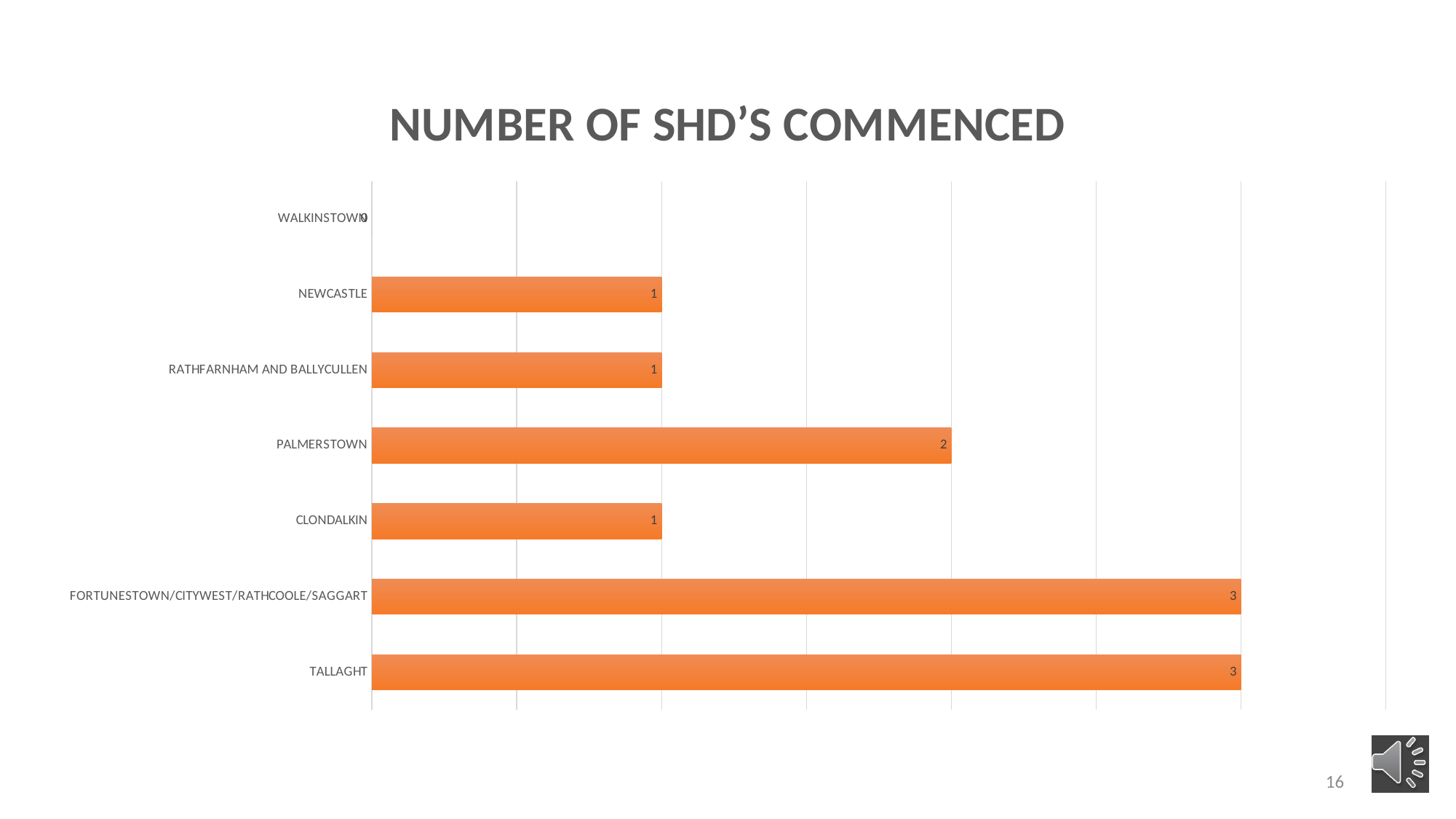
What is the number of SHD's commenced for Palmerstown? 2 What is the title of the chart? NUMBER OF SHD'S COMMENCED How many categories are shown in the chart? 7 What is the difference between the values for Fortunestown/Citywest/Rathcoole/Saggart and Clondalkin? 2 Which category has the lowest number of SHD's commenced? Walkinstown What is the number of SHD's commenced for Tallaght? 3 What is the number of SHD's commenced for Newcastle? 1 What is the difference between the values for Tallaght and Palmerstown? 1 What kind of chart is shown on the slide? Bar chart What is the number of SHD's commenced for Walkinstown? 0 Which is larger, the value for Palmerstown or the value for Rathfarnham and Ballycullen? Palmerstown What colour are the bars in the chart? Orange